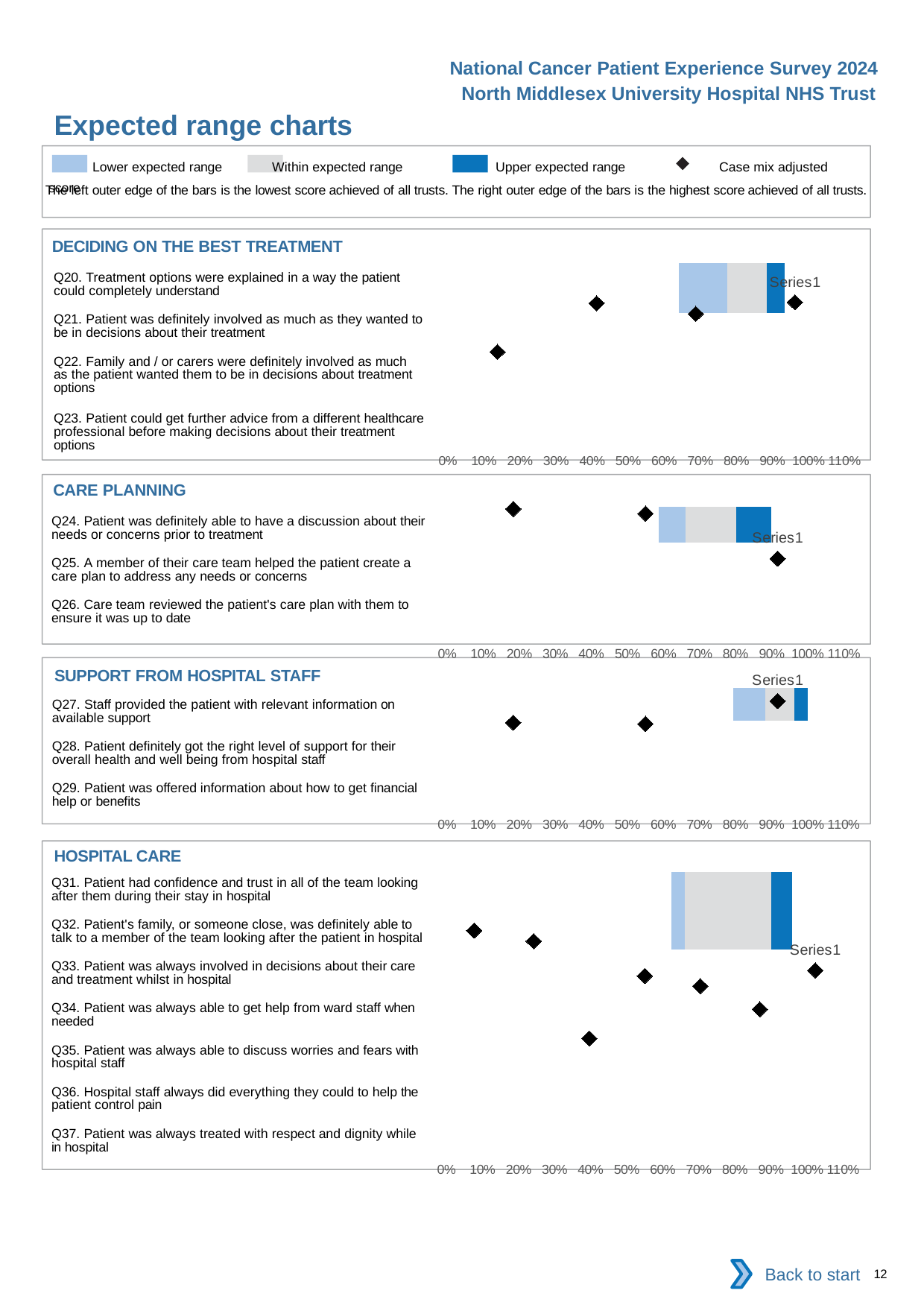
What kind of chart is used in the 'DECIDING ON THE BEST TREATMENT' section? bar chart How many entries does the legend at the top of the slide list? 4 How many questions are listed in the 'CARE PLANNING' chart? 3 How many questions are listed in the 'HOSPITAL CARE' chart? 7 Which question number is the last listed in the 'CARE PLANNING' chart? Q26 Which question number is the first listed in the 'HOSPITAL CARE' chart? Q31 How many expected range charts are shown on the slide? 4 What is the highest tick label on the x axis of the 'HOSPITAL CARE' chart? 110% Which legend entry is represented by a diamond marker? Case mix adjusted score